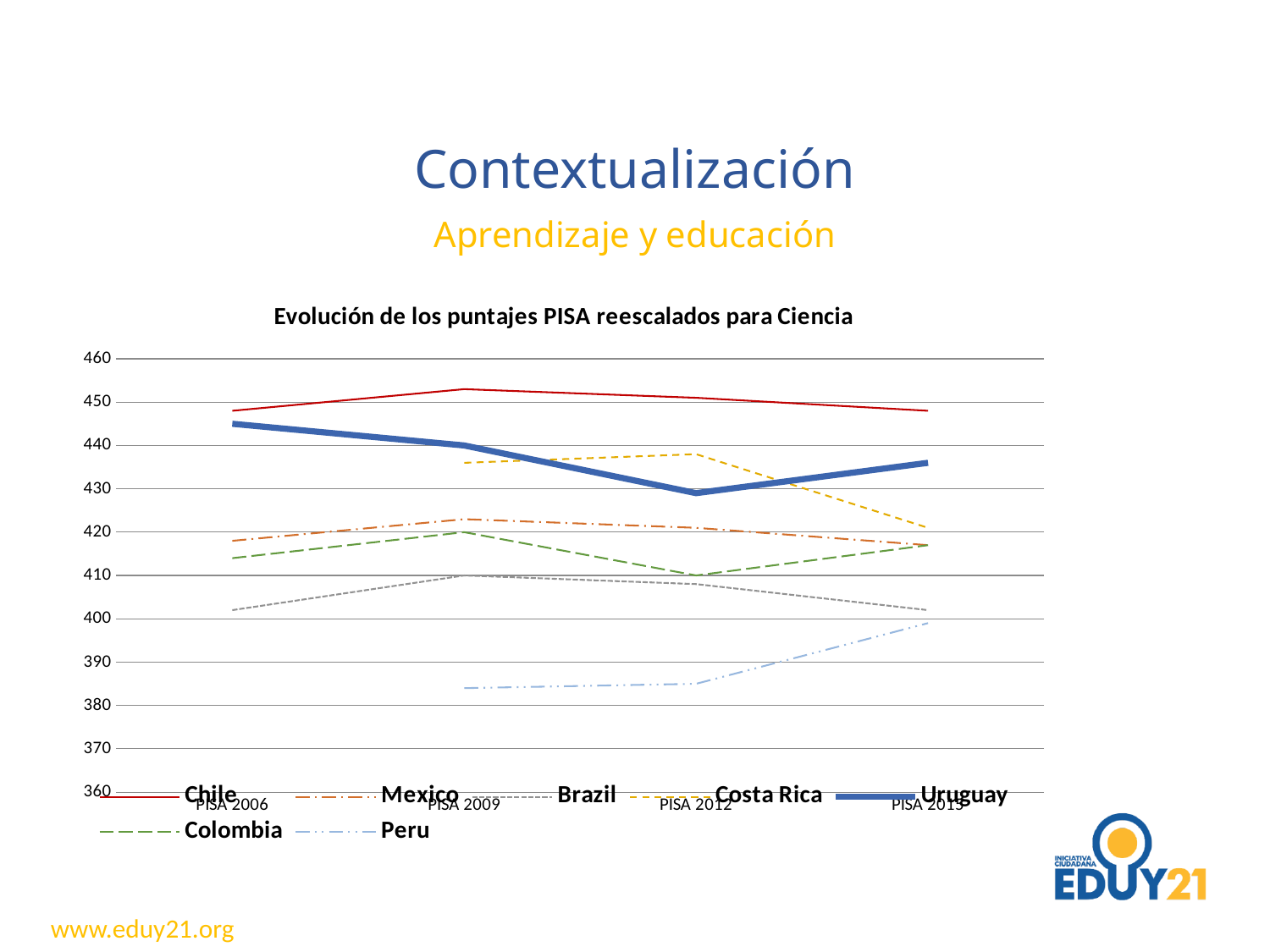
What is the title of the chart? Evolución de los puntajes PISA reescalados para Ciencia Which country has the highest score at PISA 2015? Chile What kind of chart is shown on the slide? line chart Which country has the lowest score at PISA 2015? Peru Is the value for Costa Rica at PISA 2009 greater or less than 430? greater Is the value for Chile at PISA 2009 greater or less than 450? greater Does the Peru line rise or fall from PISA 2012 to PISA 2015? rise How many series does the legend list? 7 Is the value for Uruguay at PISA 2006 greater or less than 440? greater At PISA 2012, which is higher, Uruguay or Costa Rica? Costa Rica How many PISA rounds are shown along the x axis? 4